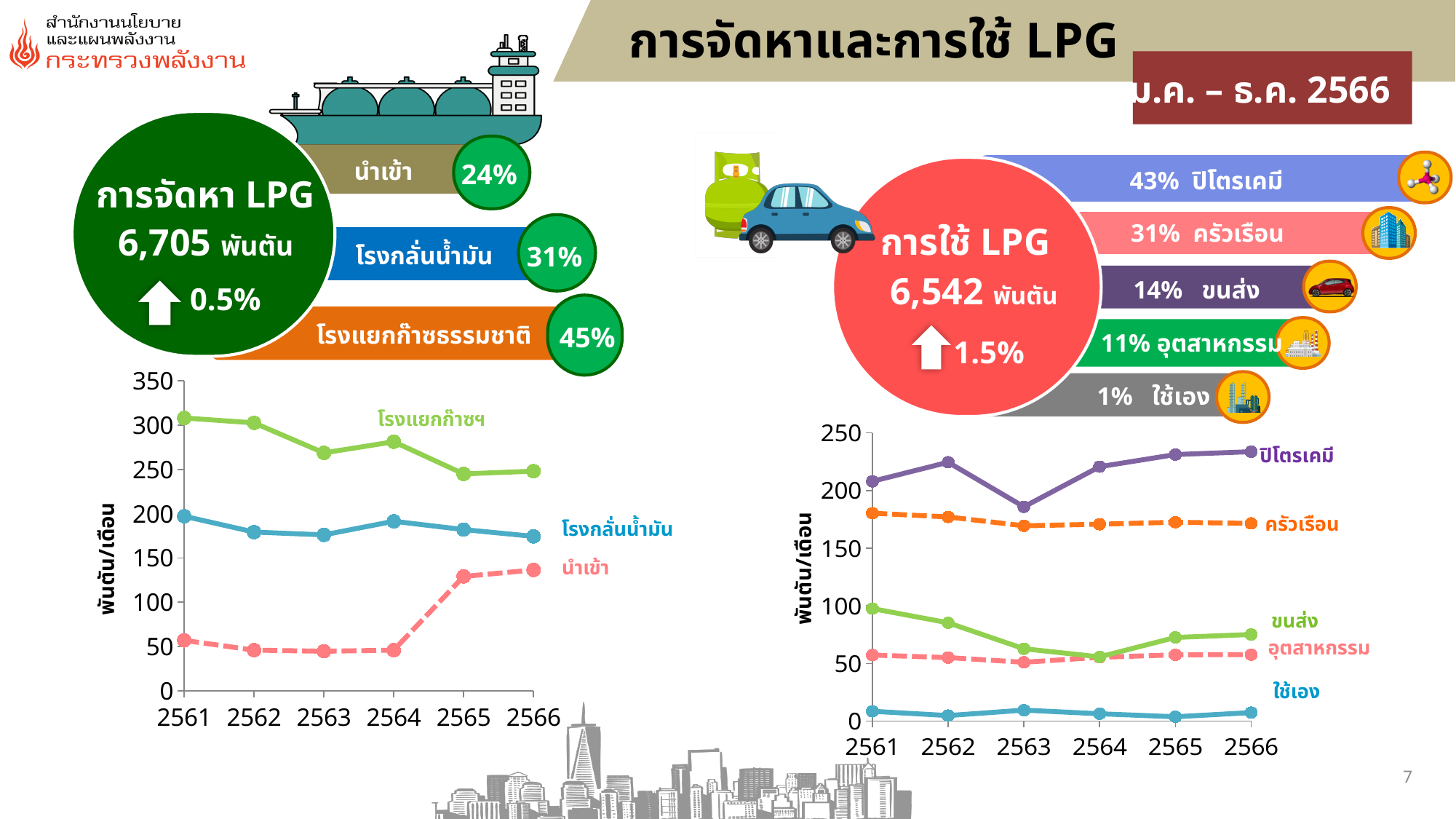
What kind of chart is the left chart (พันตัน/เดือน, years 2561–2566)? line chart How many years are shown on the x axis of the right chart (พันตัน/เดือน)? 6 In the right chart, is the value for ปิโตรเคมี in 2566 greater or less than 200? greater How many series are plotted in the left chart (พันตัน/เดือน)? 3 In the left chart, which series has the highest values across all years? โรงแยกก๊าซฯ In the right chart, which is larger in 2561: ขนส่ง or อุตสาหกรรม? ขนส่ง In the left chart, does the นำเข้า series rise or fall from 2561 to 2566? rise How many series are plotted in the right chart (พันตัน/เดือน)? 5 In the left chart, is the value for โรงแยกก๊าซฯ in 2561 greater or less than 300? greater In the right chart, which series has the lowest values across all years? ใช้เอง What is the y-axis label of the right chart? พันตัน/เดือน In the left chart, is the value for นำเข้า in 2563 greater or less than 100? less